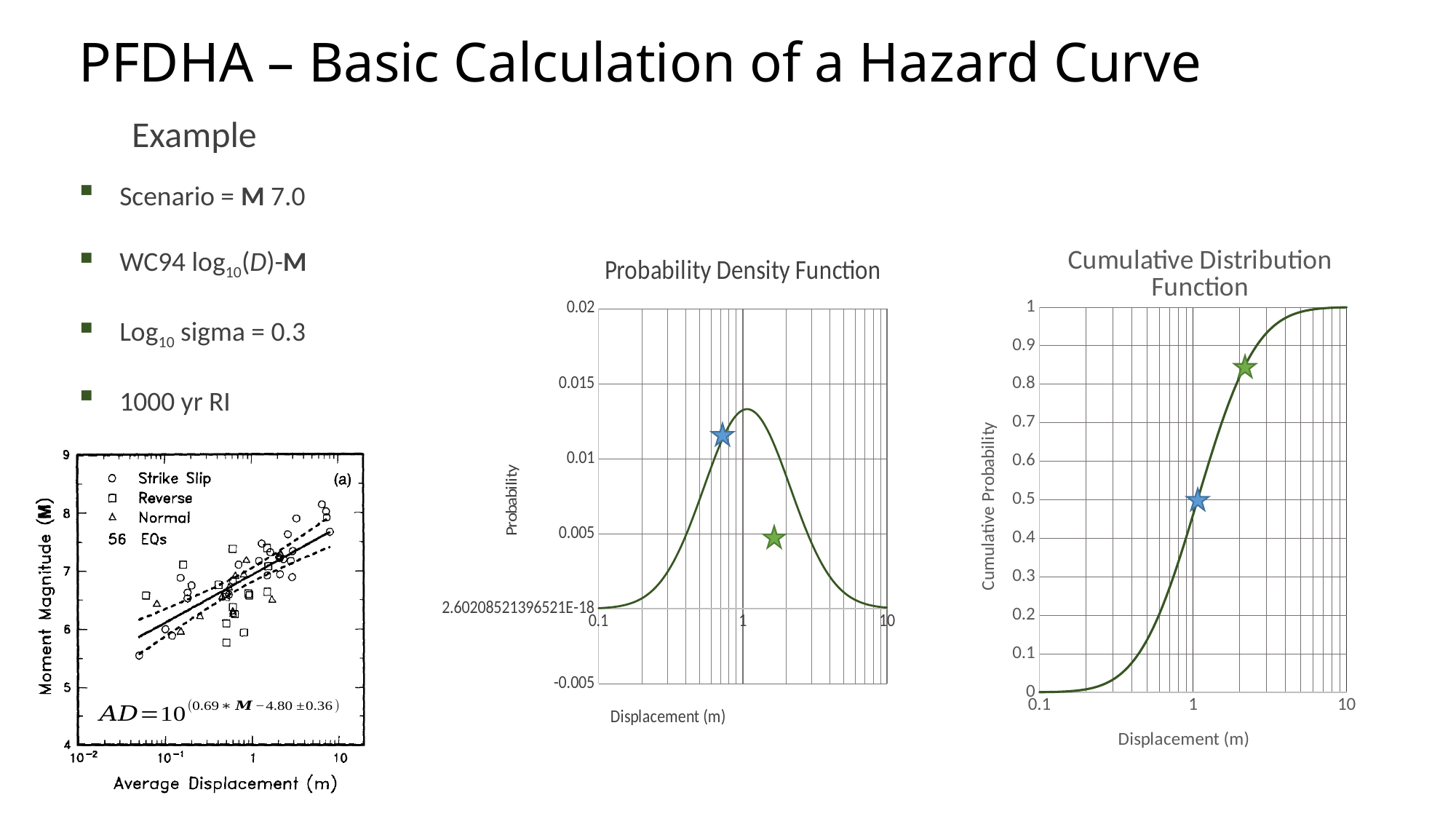
How many fault types does the legend of the bottom-left scatter plot list? 3 How many earthquakes (EQs) does the bottom-left scatter plot state it includes? 56 In the Cumulative Distribution Function chart, is the cumulative probability at a displacement of 10 m greater or less than 0.9? greater In the Cumulative Distribution Function chart, is the cumulative probability at a displacement of 1 m greater or less than 0.4? greater What is the y-axis title of the Cumulative Distribution Function chart? Cumulative Probability In the Probability Density Function chart, is the probability at a displacement of 0.1 m greater or less than 0.005? less What kind of chart is the Probability Density Function chart? line chart What kind of chart is the bottom-left chart of Moment Magnitude versus Average Displacement? scatter plot How many star markers are plotted on the Cumulative Distribution Function chart? 2 In the Cumulative Distribution Function chart, do the values rise or fall as displacement increases along the x axis? rise